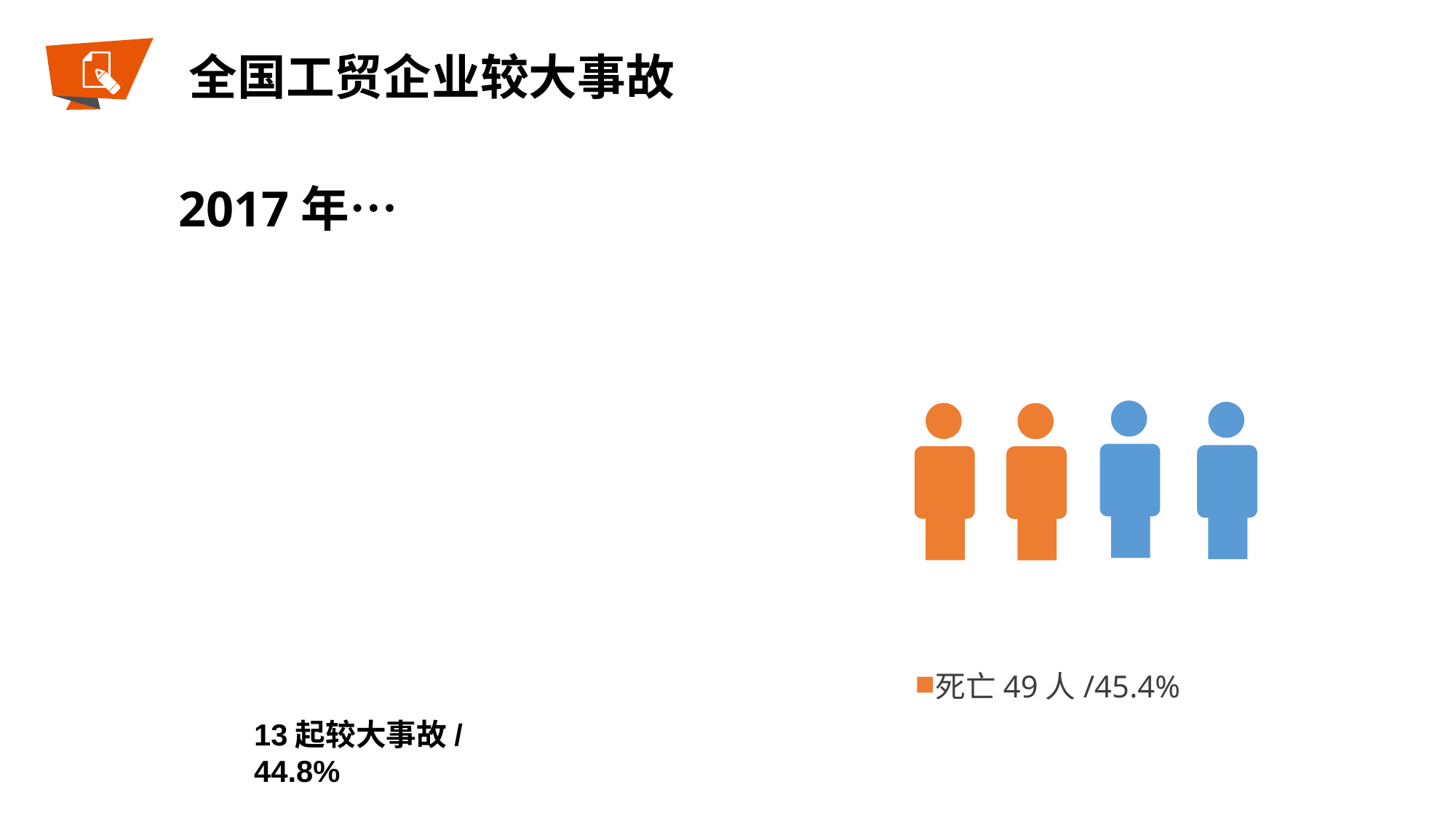
How many person icons are shown in the pictograph on the right? 4 What colour is the legend marker for 死亡 49 人 /45.4%? orange What kind of chart is shown on the right of the slide? pictograph (icon chart) How many entries does the legend of the pictograph list? 1 How many of the person icons in the pictograph are blue? 2 What does the legend entry of the pictograph on the right read? 死亡 49 人 /45.4% How many of the person icons in the pictograph are orange? 2 According to the legend, how many deaths (死亡) are reported? 49 人 According to the legend, what percentage is shown for 死亡? 45.4%